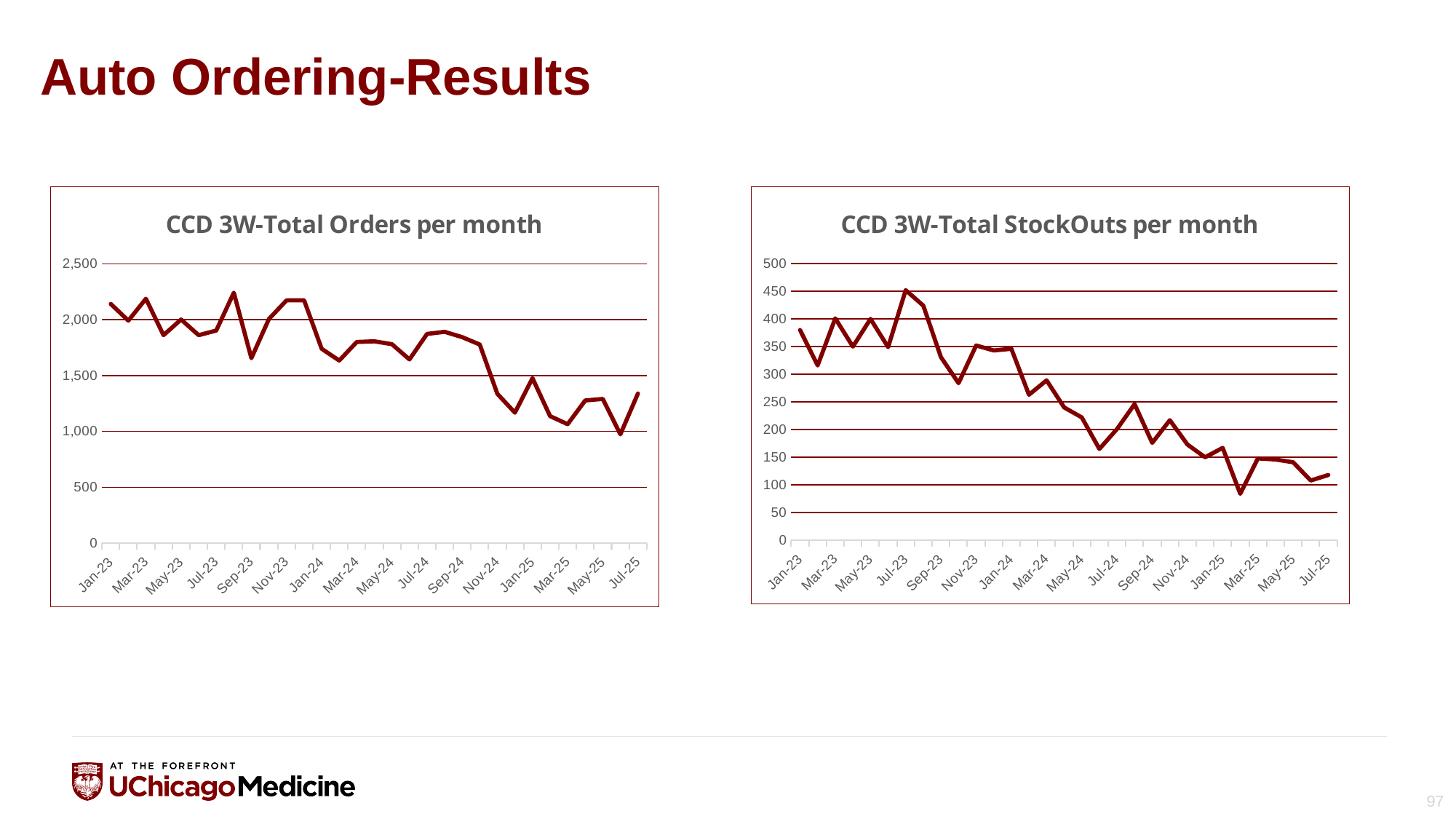
What kind of chart is the 'CCD 3W-Total StockOuts per month' chart? line chart What kind of chart is the 'CCD 3W-Total Orders per month' chart? line chart In the 'CCD 3W-Total StockOuts per month' chart, do the values generally rise or fall from Jan-23 to Jul-25? fall In the 'CCD 3W-Total Orders per month' chart, is the value for Jul-25 greater or less than 1,000? greater In the 'CCD 3W-Total StockOuts per month' chart, which month has the highest value? Jul-23 In the 'CCD 3W-Total StockOuts per month' chart, which month has the lowest value? Feb-25 In the 'CCD 3W-Total Orders per month' chart, which is larger, the value for Jan-23 or the value for Jul-25? Jan-23 In the 'CCD 3W-Total StockOuts per month' chart, is the value for Mar-25 greater or less than 100? greater In the 'CCD 3W-Total Orders per month' chart, do the values generally rise or fall from Jan-23 to Jul-25? fall In the 'CCD 3W-Total StockOuts per month' chart, is the value for Jul-25 greater or less than 150? less How many month labels are shown on the x axis of the 'CCD 3W-Total StockOuts per month' chart? 16